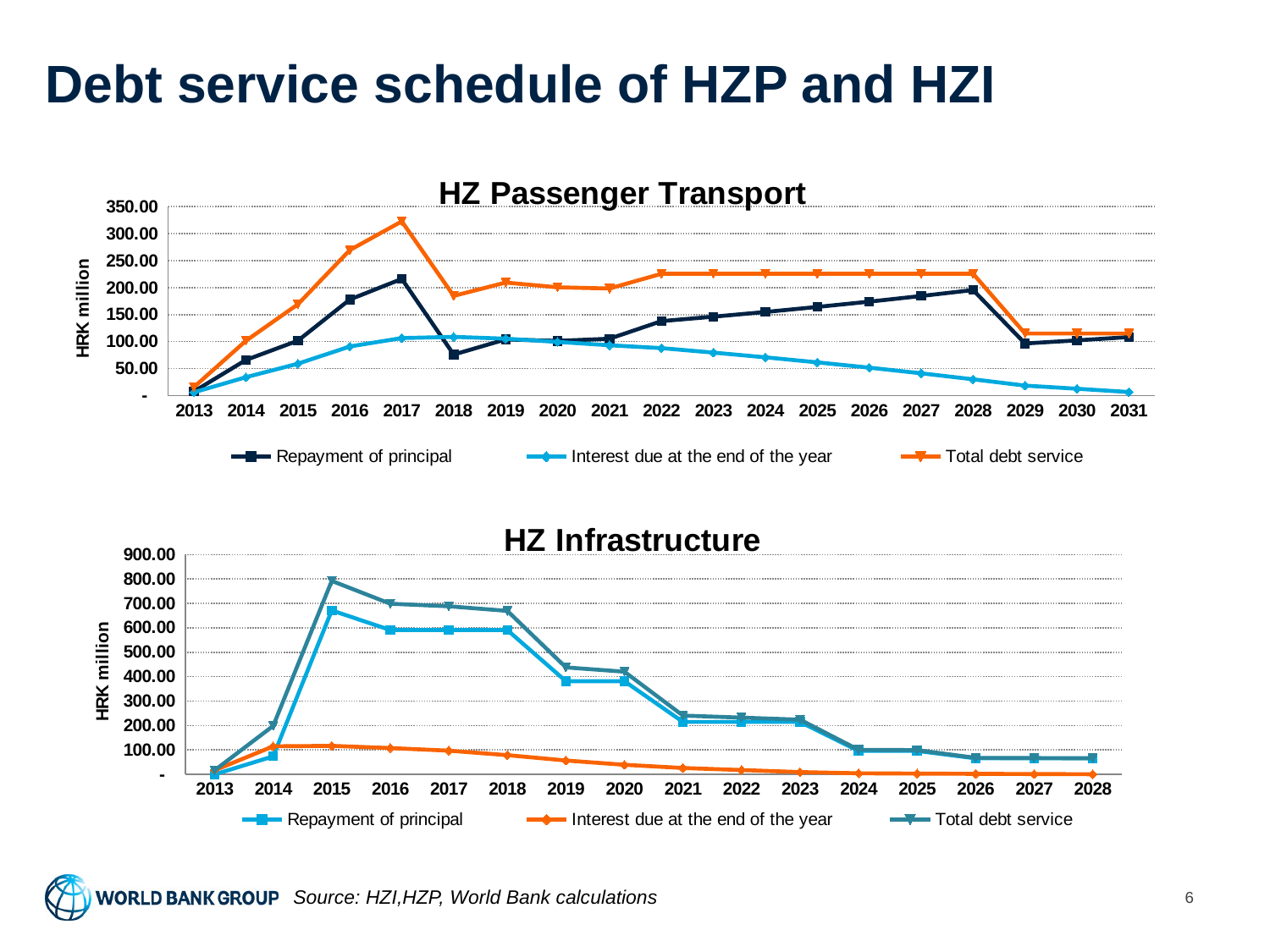
How many series does the legend of the HZ Infrastructure chart list? 3 In the HZ Infrastructure chart, which is larger: Total debt service in 2014 or in 2015? 2015 How many years are plotted on the x axis of the HZ Passenger Transport chart? 19 In the HZ Infrastructure chart, is the Total debt service value for 2015 greater or less than 700.00? greater What is the y-axis label on the HZ Infrastructure chart? HRK million In the HZ Passenger Transport chart, in which year is Total debt service highest? 2017 In the HZ Infrastructure chart, in which year is Total debt service highest? 2015 How many years are plotted on the x axis of the HZ Infrastructure chart? 16 In the HZ Passenger Transport chart, is the Repayment of principal value for 2018 greater or less than 100.00? less What kind of chart is the HZ Passenger Transport chart? Line chart In the HZ Passenger Transport chart, is the Total debt service value for 2017 greater or less than 300.00? greater In the HZ Infrastructure chart, does Interest due at the end of the year rise or fall from 2015 to 2028? Fall